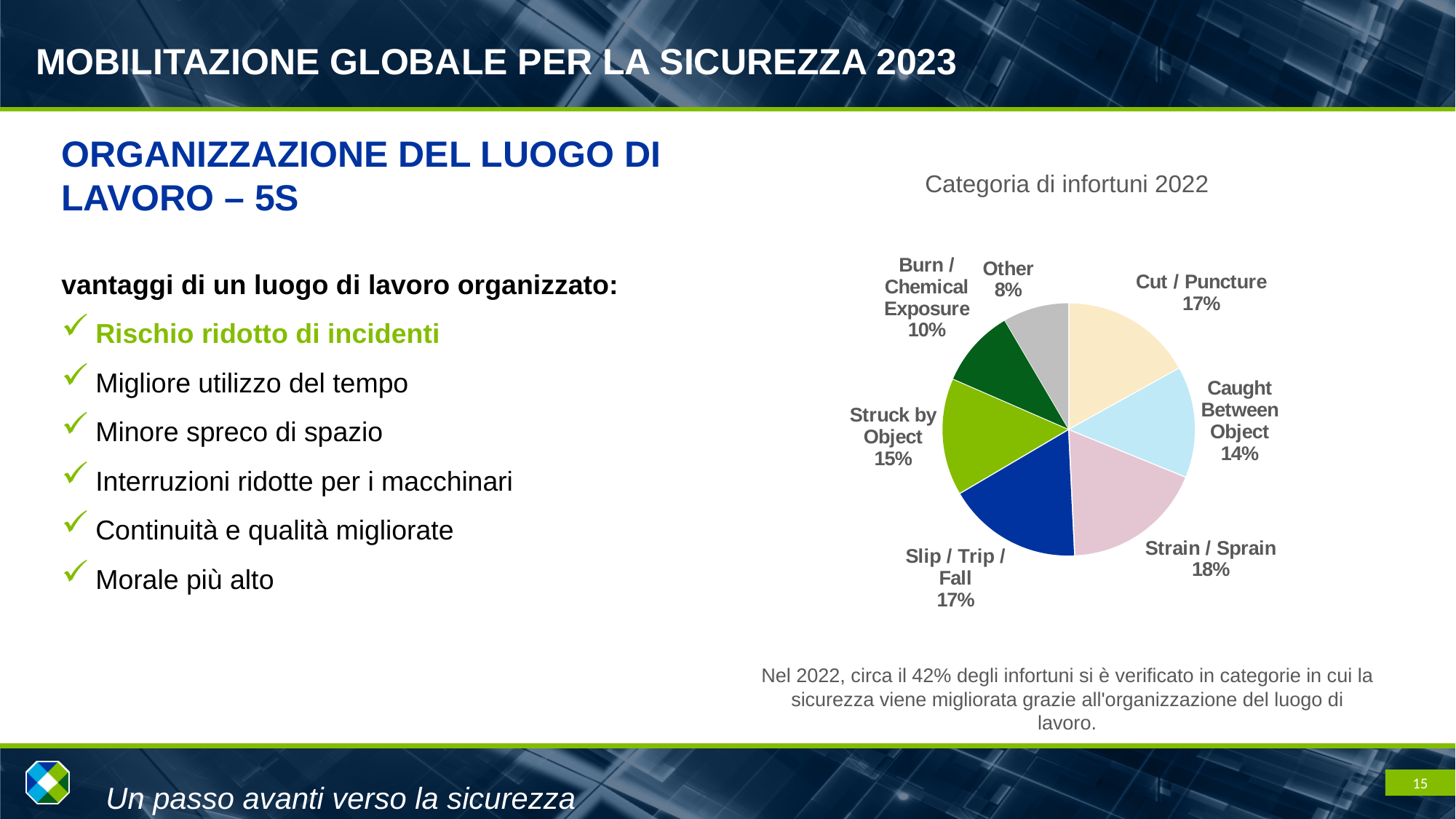
What kind of chart is shown on the slide? Pie chart Which category has the largest share of injuries? Strain / Sprain What share of injuries is Burn / Chemical Exposure? 10% What share of injuries is Caught Between Object? 14% What is the combined share of Slip / Trip / Fall and Struck by Object? 32% Which category has the smallest share of injuries? Other What is the difference in percentage points between Cut / Puncture and Other? 9 How many categories does the pie chart show? 7 Which is larger, the share for Struck by Object or the share for Caught Between Object? Struck by Object What is the title of the chart? Categoria di infortuni 2022 What share of injuries is Strain / Sprain? 18% What share of injuries is Struck by Object? 15%